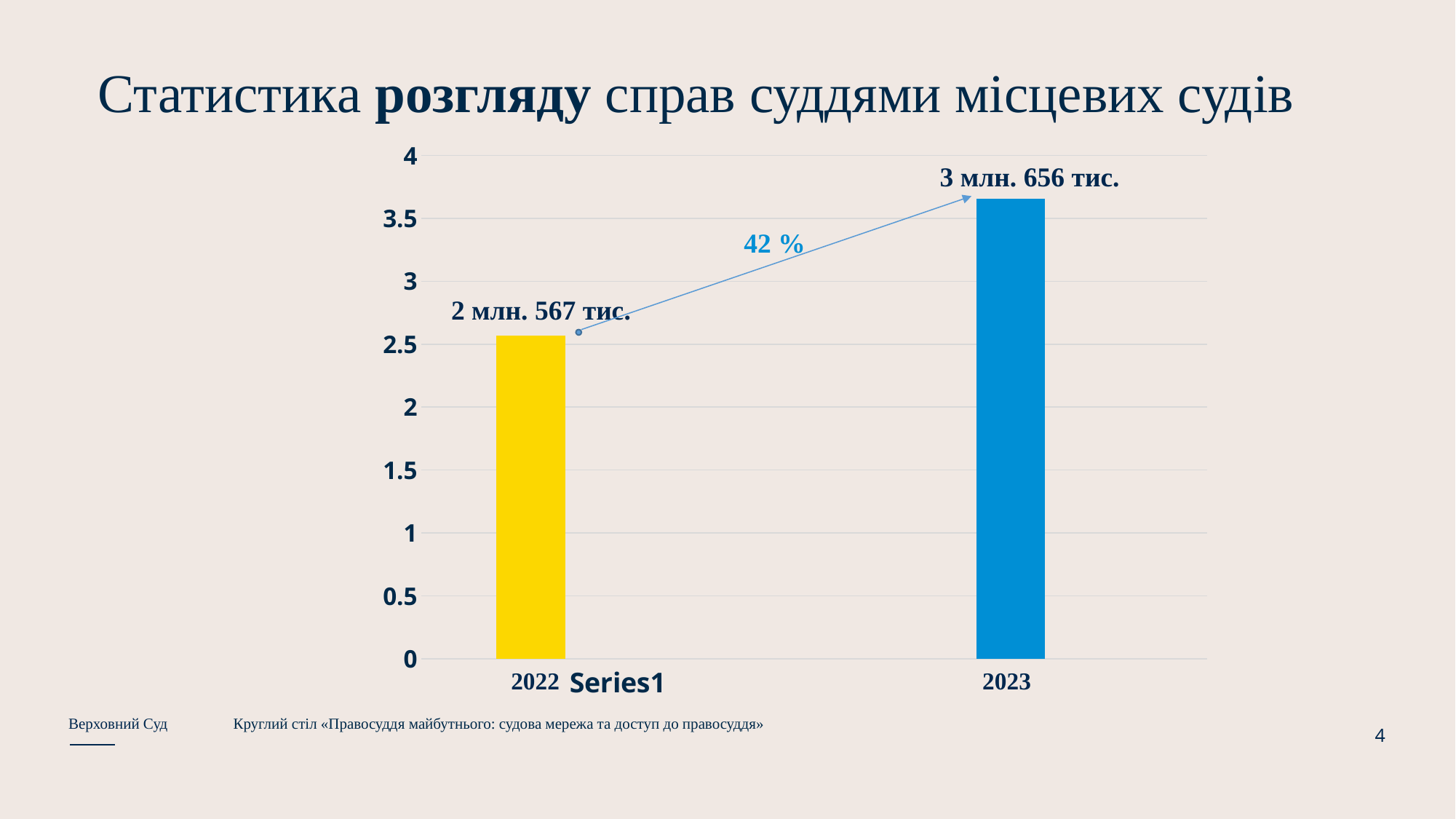
What is the difference between the 2023 and 2022 values? 1 млн. 89 тис. Do the values rise or fall from 2022 to 2023? rise What percentage change is written next to the arrow between the two bars? 42 % Which year has the higher value? 2023 How many bars are plotted in the chart? 2 What value is shown for 2022? 2 млн. 567 тис. Is the value for 2022 greater or less than 3? less What colour is the bar for 2022? yellow What value is shown for 2023? 3 млн. 656 тис. Which year has the lower value? 2022 What kind of chart is shown on the slide? bar chart Is the value for 2023 greater or less than 3.5? greater